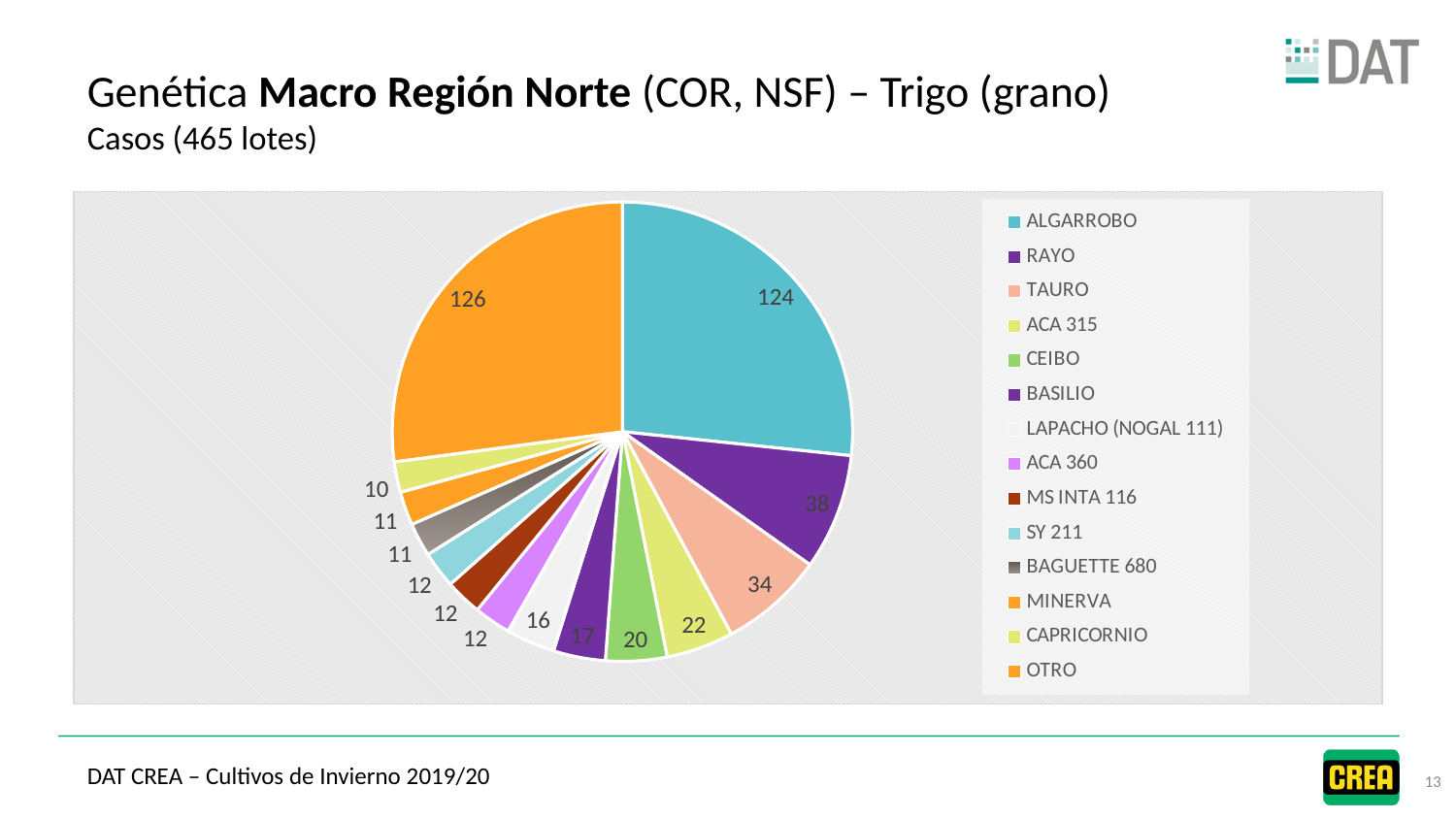
How many categories does the legend list? 14 What is the value shown for CEIBO? 20 What type of chart is shown on the slide? Pie chart What share of the 465 lotes does the OTRO slice represent? 27.1% What is the value shown for RAYO? 38 What is the value shown for the OTRO slice? 126 What is the difference between the values for RAYO and TAURO? 4 How many cases (lotes) does the ALGARROBO slice represent? 124 Which category has the smallest slice of the pie? CAPRICORNIO Which has a larger value, ACA 315 or CEIBO? ACA 315 What is the subtitle shown under the slide title? Casos (465 lotes) Which category has the largest slice of the pie? OTRO